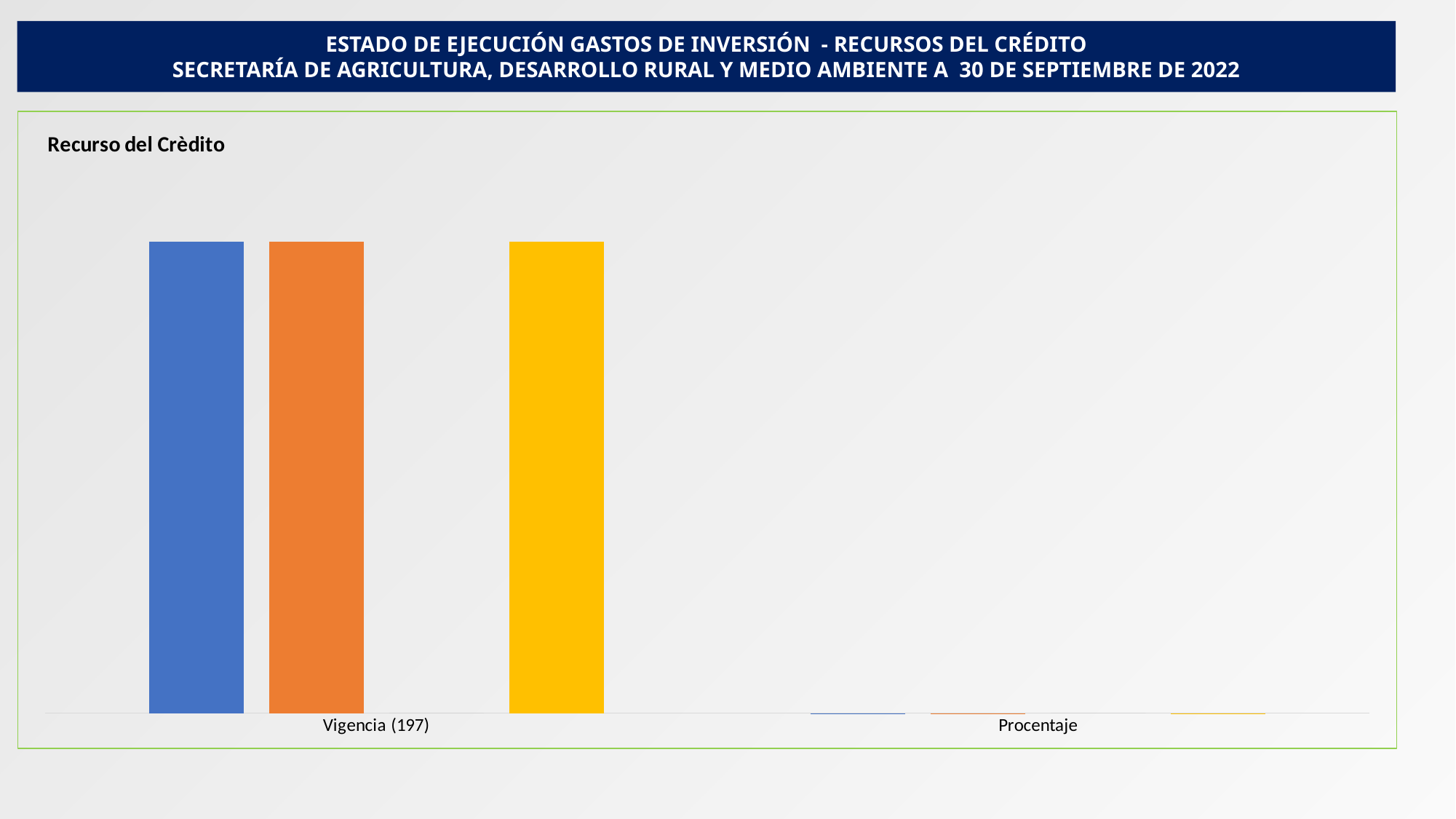
What are the two category labels on the x axis? Vigencia (197) and Procentaje Do the bar heights rise or fall from Vigencia (197) to Procentaje along the x axis? fall Which category has the lowest bars in the chart? Procentaje What is the title of the chart? Recurso del Crèdito What kind of chart is shown on the slide? bar chart Which category has the taller bars, Vigencia (197) or Procentaje? Vigencia (197) Which category has the highest bars in the chart? Vigencia (197) How many categories are shown on the x axis of the chart? 2 How many bars are plotted for the category Vigencia (197)? 3